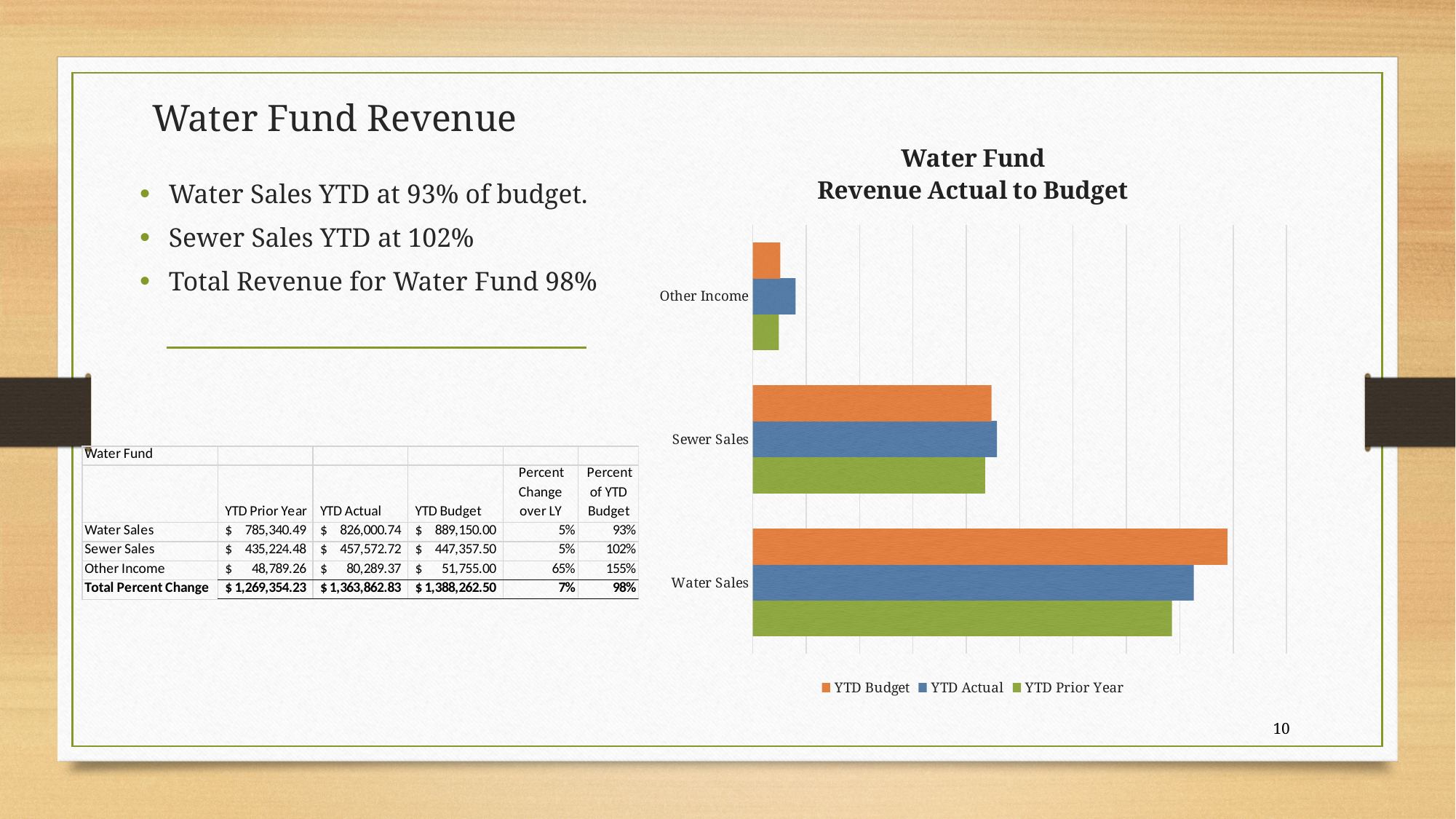
For Water Sales, which series has the shortest bar? YTD Prior Year What is the title of the chart? Water Fund Revenue Actual to Budget How many categories are plotted on the chart? 3 How many series does the chart legend list? 3 Which is larger: the YTD Budget bar for Sewer Sales or the YTD Budget bar for Other Income? Sewer Sales Which series is shown in orange on the chart? YTD Budget Which category has the longest bars on the chart? Water Sales For Other Income, which is larger: YTD Actual or YTD Budget? YTD Actual What kind of chart is shown on the slide? Bar chart For Water Sales, which is larger: YTD Budget or YTD Actual? YTD Budget Which category has the shortest bars on the chart? Other Income